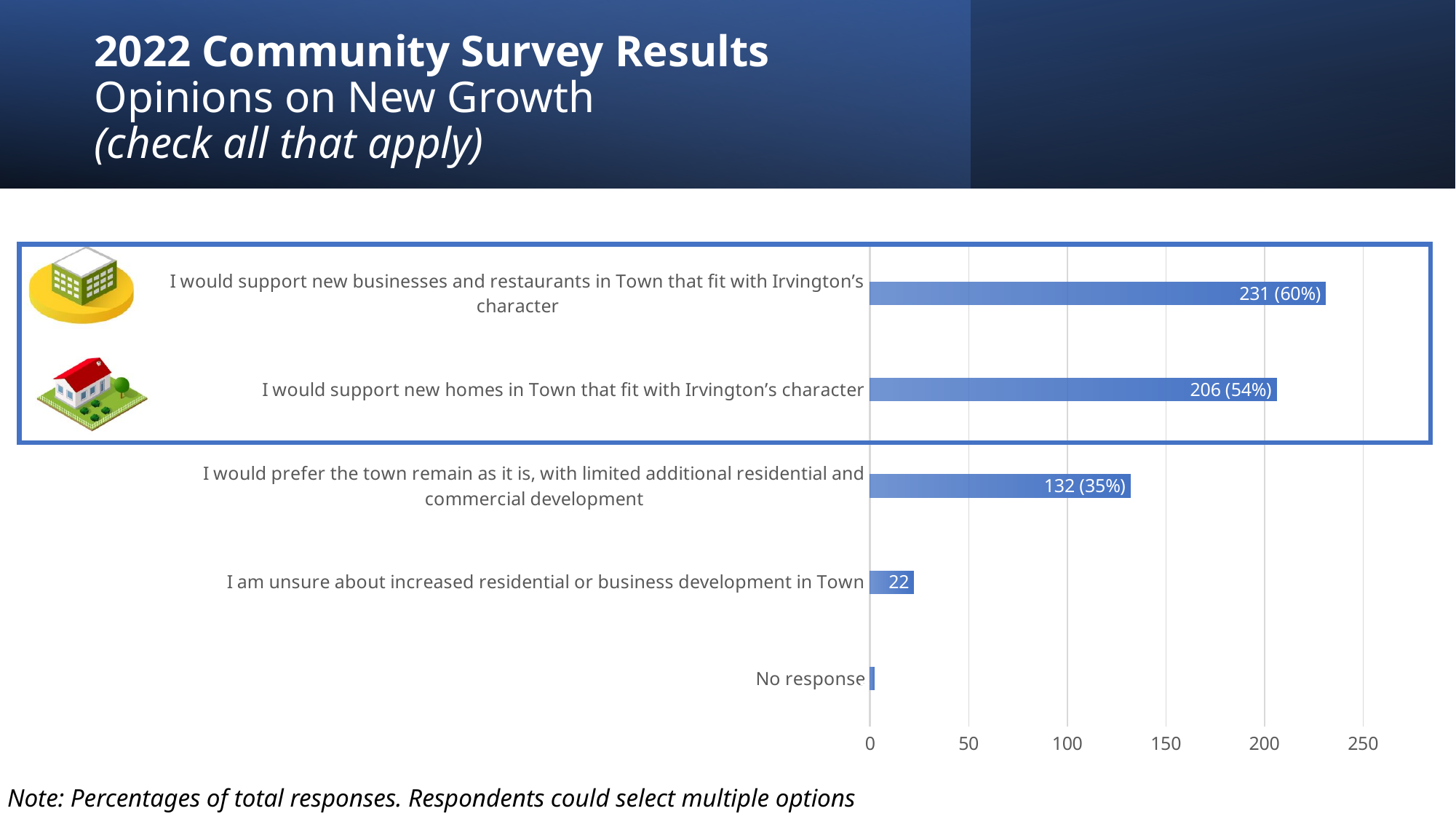
Is the value for "No response" greater or less than 50? less What is the maximum value shown on the horizontal axis? 250 How many respondents selected "I am unsure about increased residential or business development in Town"? 22 What is the difference in count between supporting new businesses and restaurants (231) and supporting new homes (206)? 25 Which category has the lowest value? No response Which category has the highest value? I would support new businesses and restaurants in Town that fit with Irvington's character What value is shown for "I would support new homes in Town that fit with Irvington's character"? 206 (54%) What value is shown for "I would prefer the town remain as it is, with limited additional residential and commercial development"? 132 (35%) How many categories are shown in the chart? 5 What kind of chart is shown on the slide? Bar chart Which is larger: the count for supporting new homes or the count for preferring the town remain as it is? I would support new homes in Town that fit with Irvington's character What value is shown for "I would support new businesses and restaurants in Town that fit with Irvington's character"? 231 (60%)